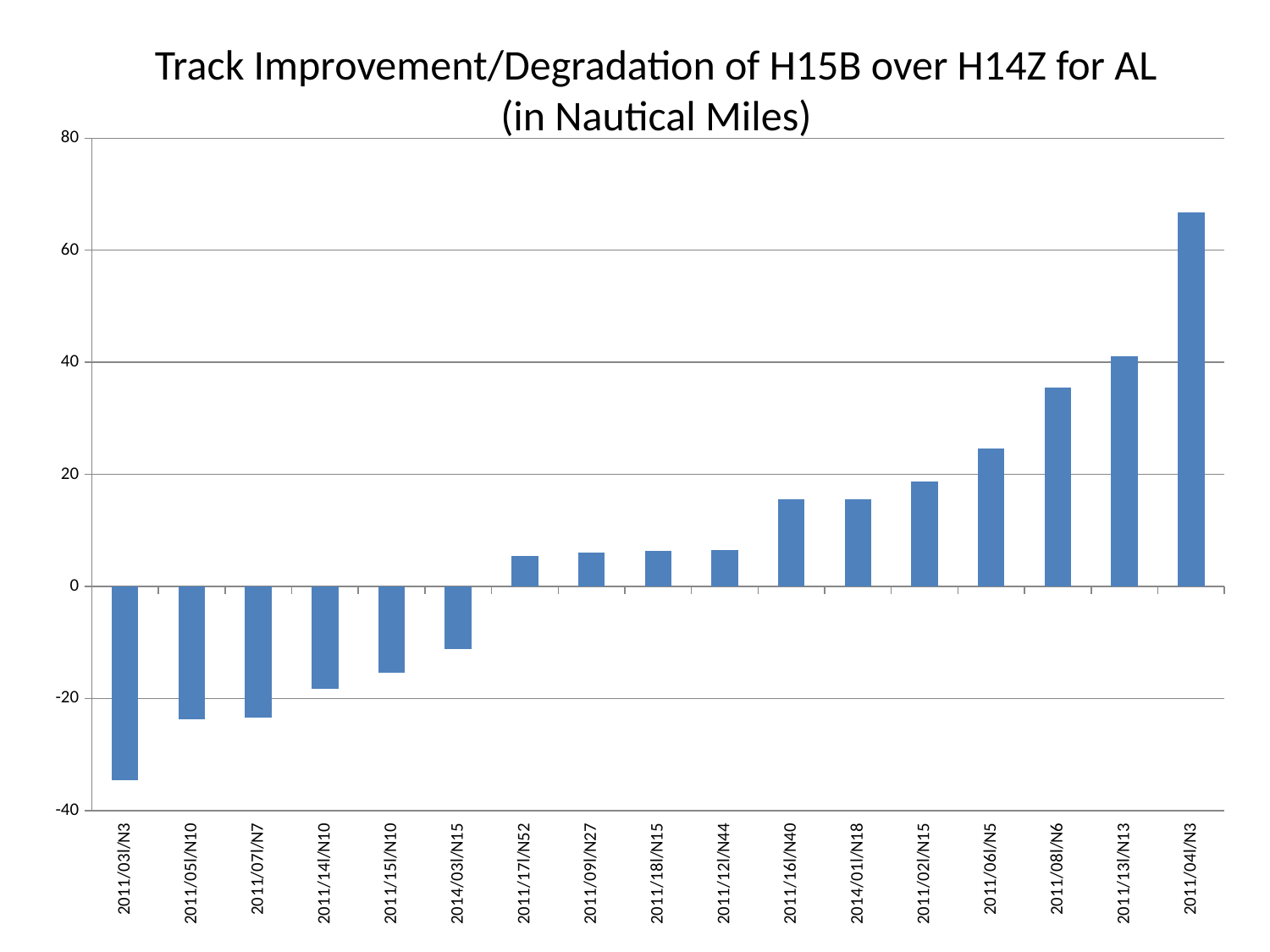
What unit does the chart title say the values are in? Nautical Miles Is the value for 2011/08l/N6 greater or less than 40? less Which is larger, the value for 2011/08l/N6 or the value for 2011/06l/N5? 2011/08l/N6 Do the values generally rise or fall from left to right along the x axis? rise Which category has the lowest value? 2011/03l/N3 How many categories are plotted along the x axis? 17 Is the value for 2011/14l/N10 greater or less than 0? less Which category has the highest value? 2011/04l/N3 What kind of chart is shown on the slide? bar chart Is the value for 2011/03l/N3 greater or less than -20? less